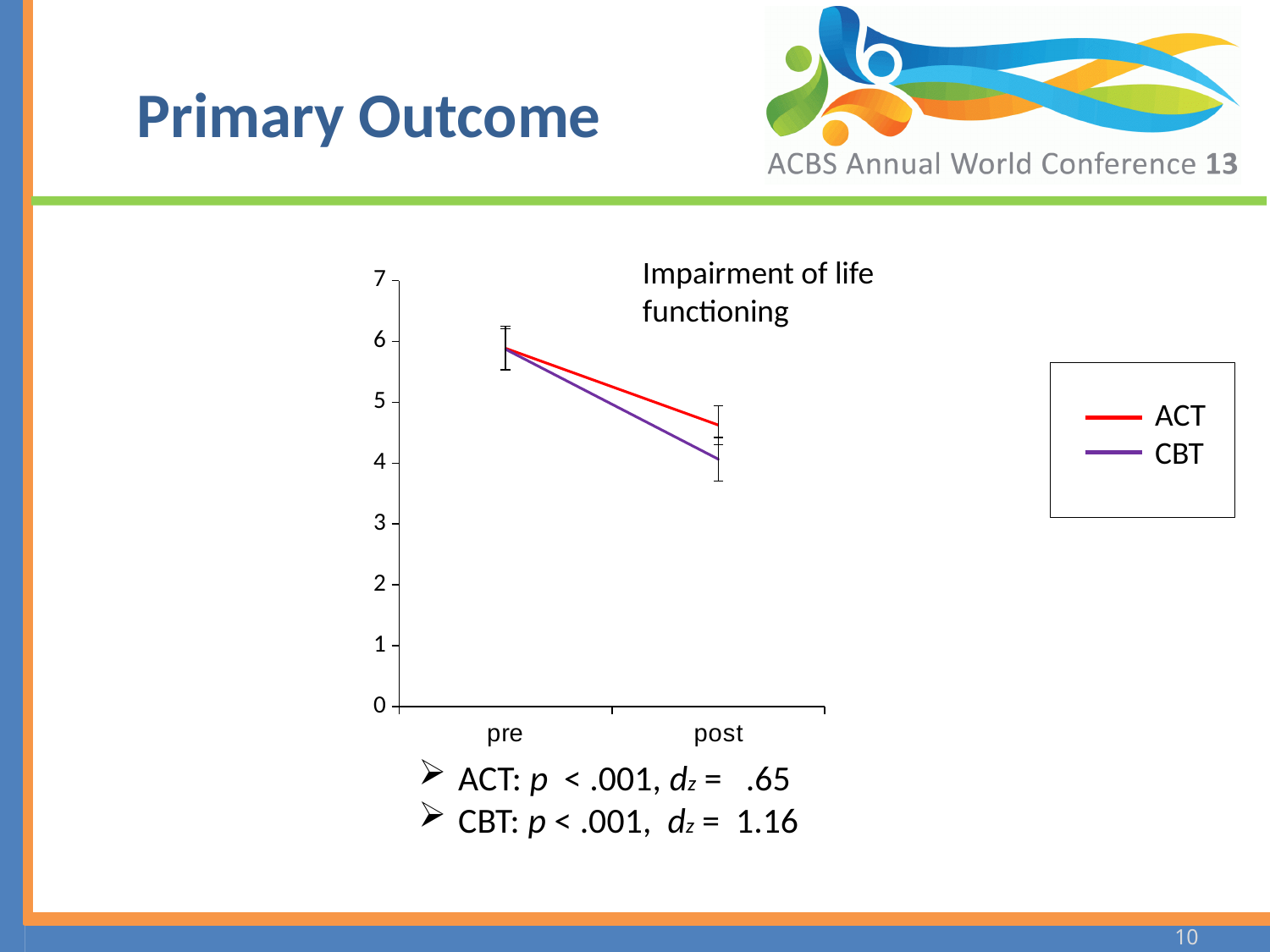
At post, which series has the lower value, ACT or CBT? CBT Is the value for CBT at post greater or less than 5? less Which series are listed in the legend? ACT and CBT Is the value for CBT at pre greater or less than 5? greater Do the values for CBT rise or fall from pre to post? fall How many series does the legend list? 2 What kind of chart is shown on the slide? line chart What is the title of the chart? Impairment of life functioning How many time points are shown on the x axis? 2 Do the values for ACT rise or fall from pre to post? fall At post, which series has the higher value, ACT or CBT? ACT Is the value for ACT at post greater or less than 5? less